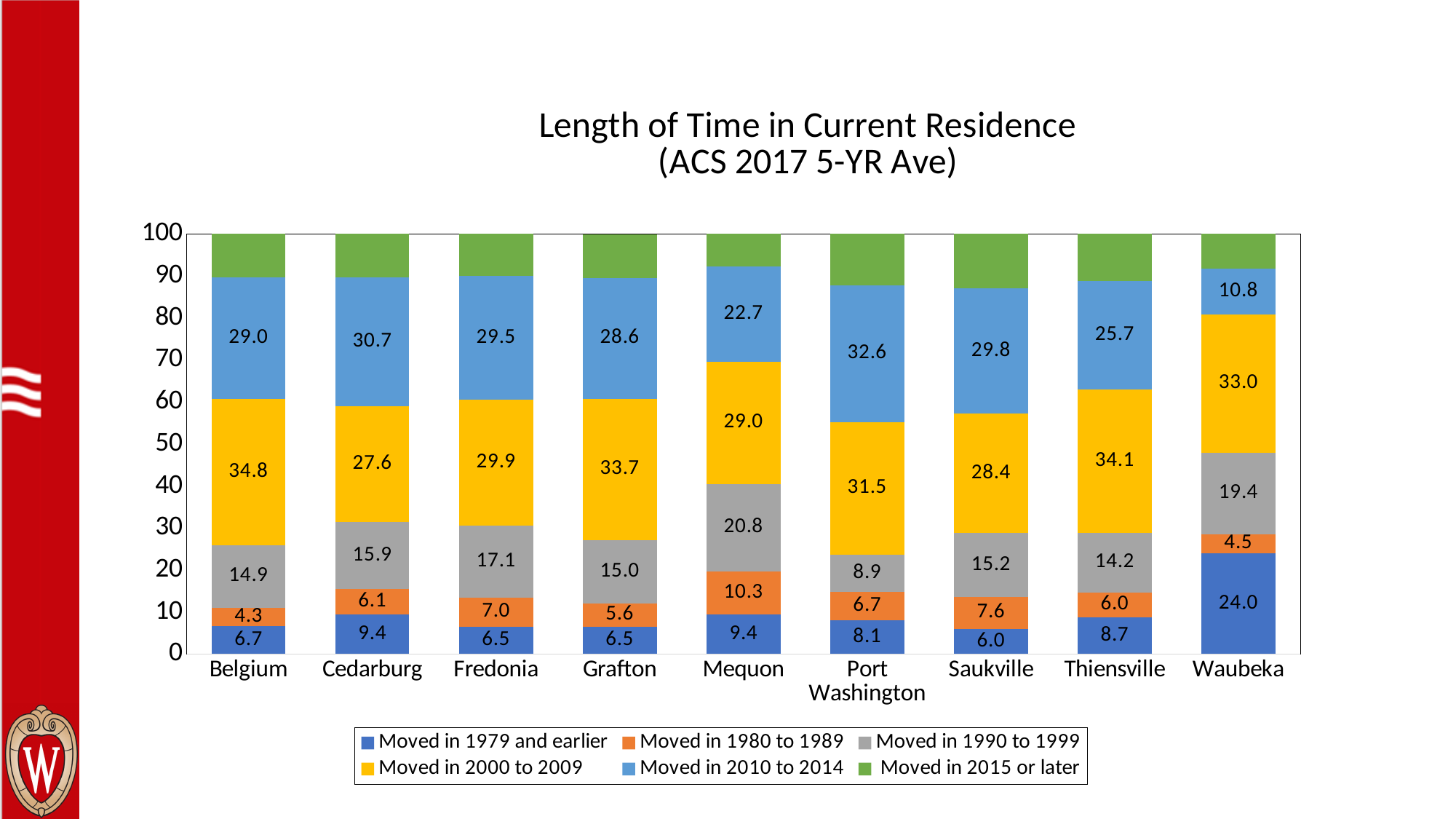
What kind of chart is shown on the slide? Stacked bar chart Which community has the highest value for 'Moved in 1979 and earlier'? Waubeka Which community has the lowest value for 'Moved in 1990 to 1999'? Port Washington What is the value for 'Moved in 2010 to 2014' for Port Washington? 32.6 How many series does the legend list? 6 Which has the larger value for 'Moved in 1980 to 1989', Mequon or Fredonia? Mequon Which community has the lowest value for 'Moved in 2010 to 2014'? Waubeka What is the value for 'Moved in 2000 to 2009' for Belgium? 34.8 How many communities are shown on the x axis of the chart? 9 What is the value for 'Moved in 1990 to 1999' for Mequon? 20.8 What is the title of the chart? Length of Time in Current Residence (ACS 2017 5-YR Ave) What is the difference between Belgium's and Cedarburg's values for 'Moved in 2000 to 2009'? 7.2